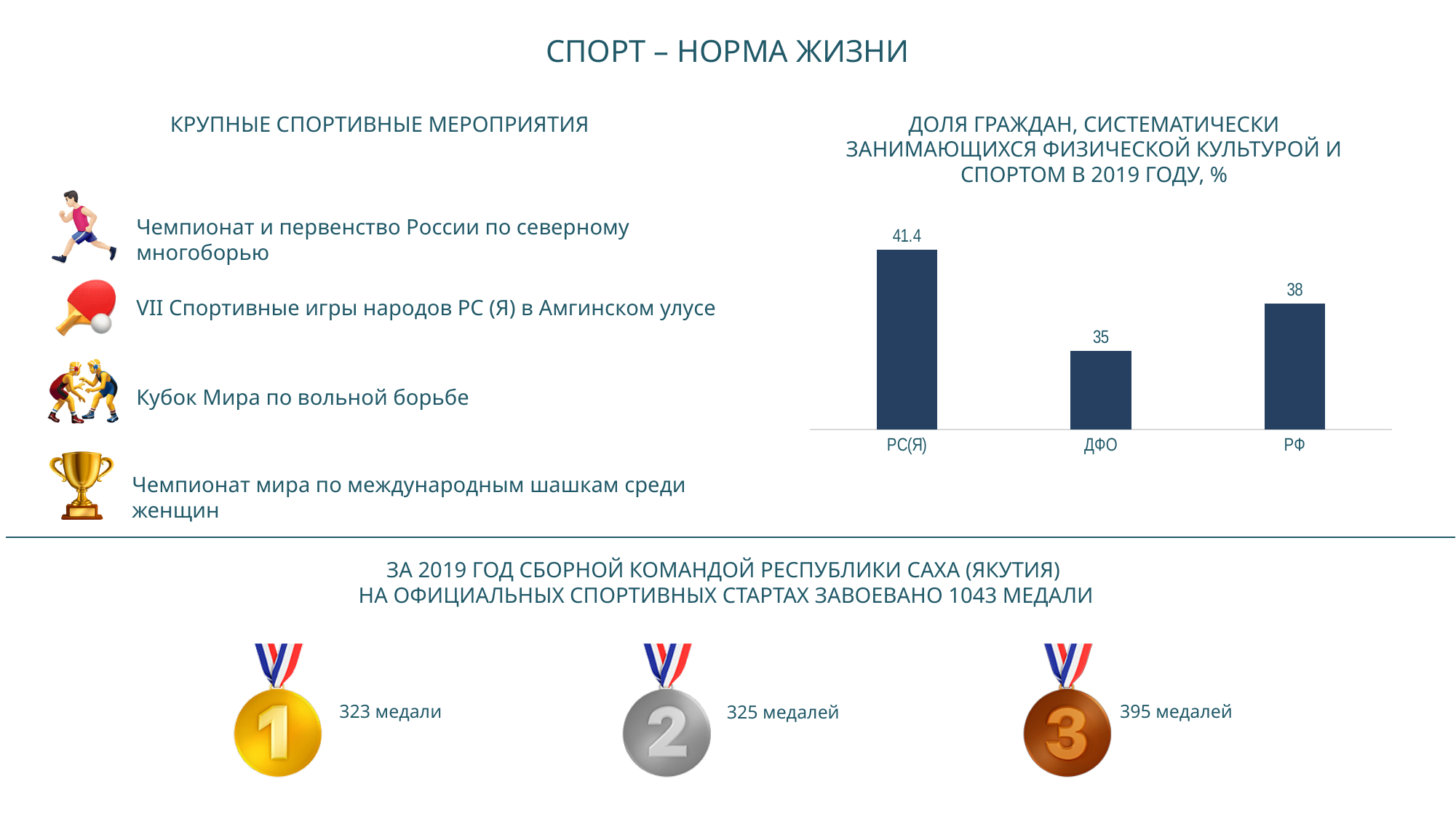
What colour are the bars in the chart? dark blue Which is larger, the value for РФ or the value for ДФО? РФ What is the title of the chart? ДОЛЯ ГРАЖДАН, СИСТЕМАТИЧЕСКИ ЗАНИМАЮЩИХСЯ ФИЗИЧЕСКОЙ КУЛЬТУРОЙ И СПОРТОМ В 2019 ГОДУ, % What kind of chart is shown on the slide? bar chart What is the value for ДФО in the chart? 35 What is the value for РФ in the chart? 38 Which category has the highest value in the chart? РС(Я) Which category has the lowest value in the chart? ДФО What is the difference between the values for РС(Я) and ДФО? 6.4 What is the difference between the values for РФ and ДФО? 3 What is the value for РС(Я) in the chart? 41.4 How many categories are shown in the chart? 3